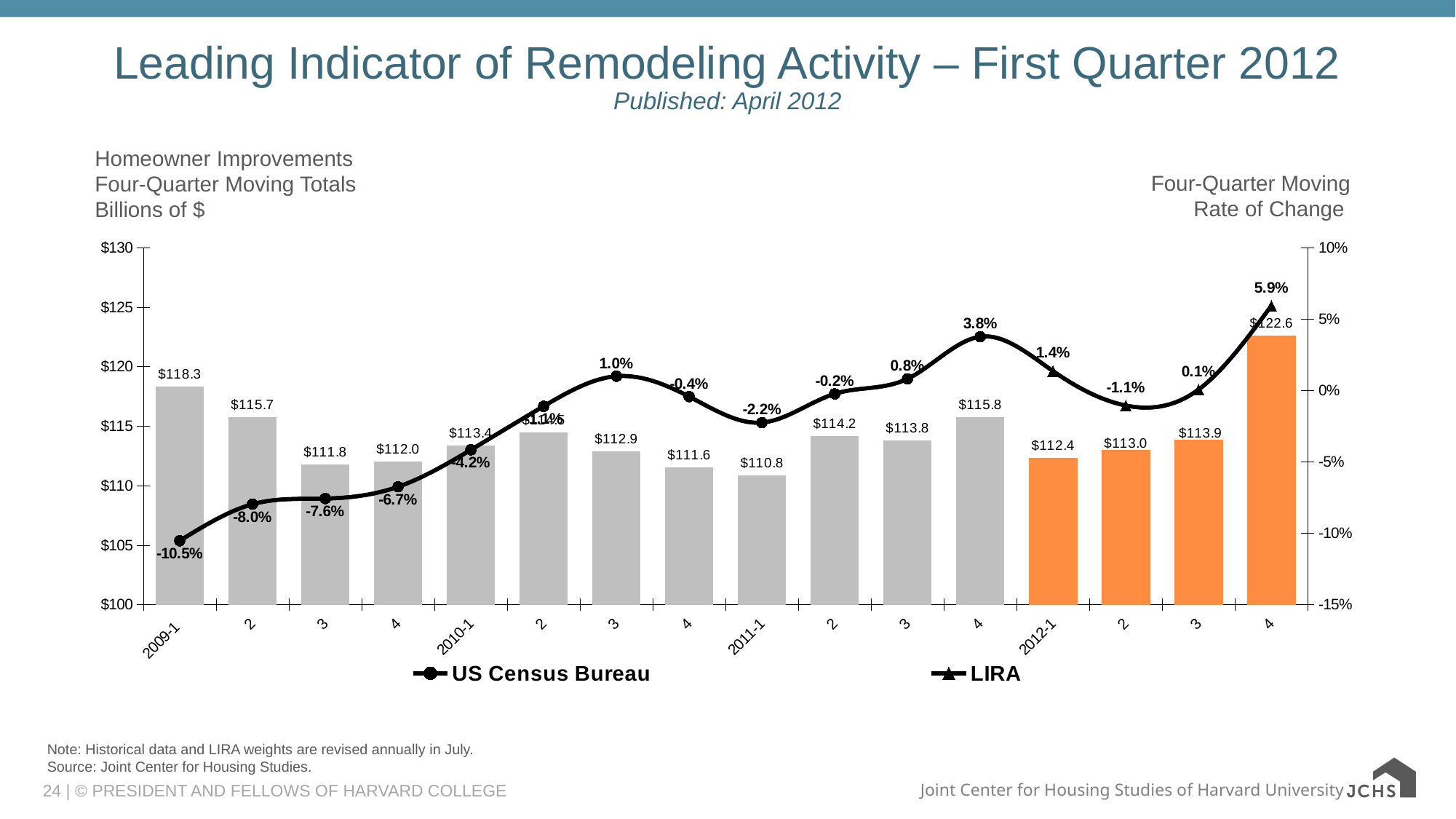
What is the four-quarter moving total of homeowner improvements for 2009-1? $118.3 What is the four-quarter moving rate of change shown for 2011-4? 3.8% Is the homeowner improvements total for 2012-1 greater or less than $115? less Which quarter has the lowest four-quarter moving rate of change? 2009-1 How many quarters are plotted on the x axis? 16 Which quarter has the lowest bar for homeowner improvements four-quarter moving totals? 2011-1 What is the four-quarter moving total of homeowner improvements for 2011-1? $110.8 Which quarter has the highest four-quarter moving rate of change? 2012-4 Which is larger, the homeowner improvements total for 2009-2 or for 2011-2? 2009-2 What is the difference between the homeowner improvements totals for 2011-4 and 2011-3? $2.0 How many series does the legend list? 2 What kind of chart is shown on the slide? Combination bar and line chart